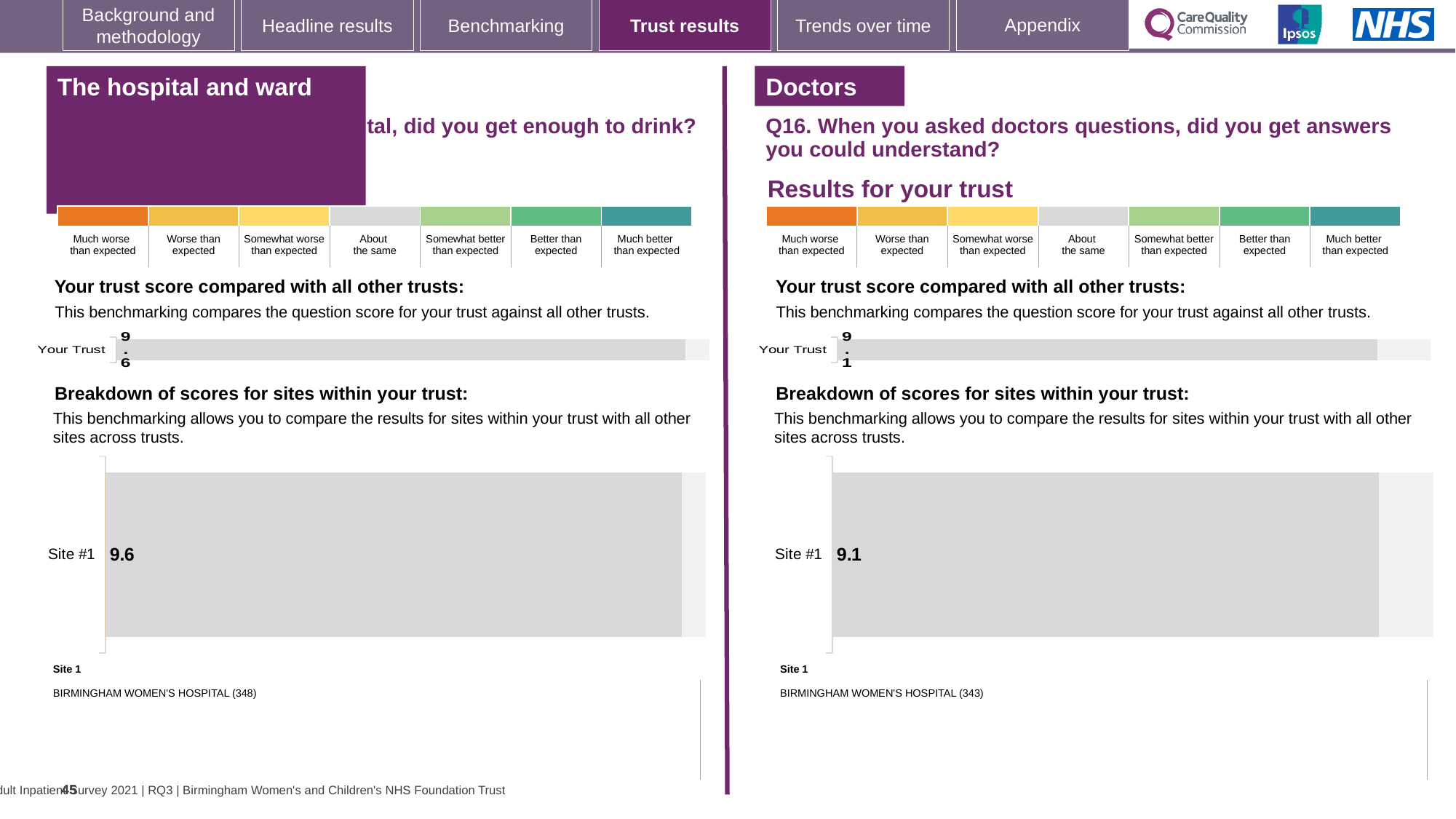
In the left-hand 'Breakdown of scores for sites within your trust' chart, what is the score for Site #1? 9.6 What is the difference between the Site #1 score in the left-hand breakdown chart and the Site #1 score in the right-hand Doctors (Q16) breakdown chart? 0.5 In the left-hand 'Your trust score compared with all other trusts' chart, what is the value shown for Your Trust? 9.6 Which hospital is listed as Site 1 beneath the right-hand Doctors (Q16) breakdown chart? BIRMINGHAM WOMEN'S HOSPITAL (343) What type of chart is used to show the Site #1 score in the left-hand breakdown section? Bar chart Is the Your Trust value in the right-hand Doctors (Q16) chart greater or less than 9.5? less Which is larger: the Your Trust score in the left-hand chart or the Your Trust score in the right-hand Doctors (Q16) chart? The left-hand chart (9.6) What is the number in brackets after Birmingham Women's Hospital beneath the left-hand breakdown chart? 348 How many sites are plotted in the right-hand 'Breakdown of scores for sites within your trust' chart? 1 In the right-hand 'Your trust score compared with all other trusts' chart under Doctors (Q16), what is the value shown for Your Trust? 9.1 In the right-hand 'Breakdown of scores for sites within your trust' chart under Doctors (Q16), what is the score for Site #1? 9.1 How many bars are shown in the left-hand 'Your trust score compared with all other trusts' chart? 1